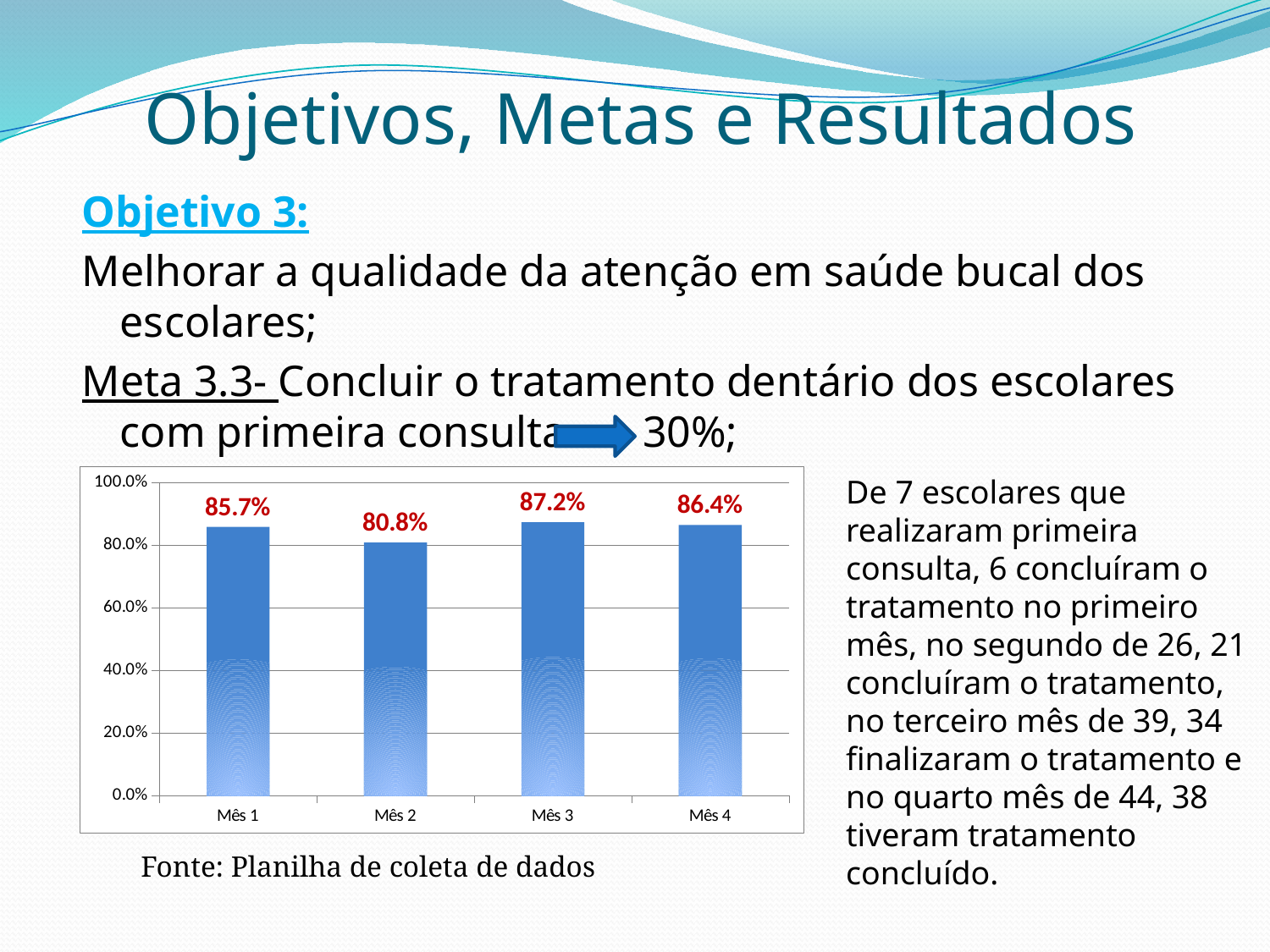
What is the source cited below the chart? Planilha de coleta de dados What is the value for Mês 2? 80.8% Which month has the highest value? Mês 3 Which is larger, the value for Mês 1 or the value for Mês 2? Mês 1 Is the value for Mês 2 greater or less than 80.0%? greater Which month has the lowest value? Mês 2 What kind of chart is shown on the slide? bar chart What is the value for Mês 3? 87.2% What is the value for Mês 4? 86.4% What is the difference between the values for Mês 3 and Mês 2? 6.4% How many months are shown on the x axis? 4 What is the value for Mês 1? 85.7%